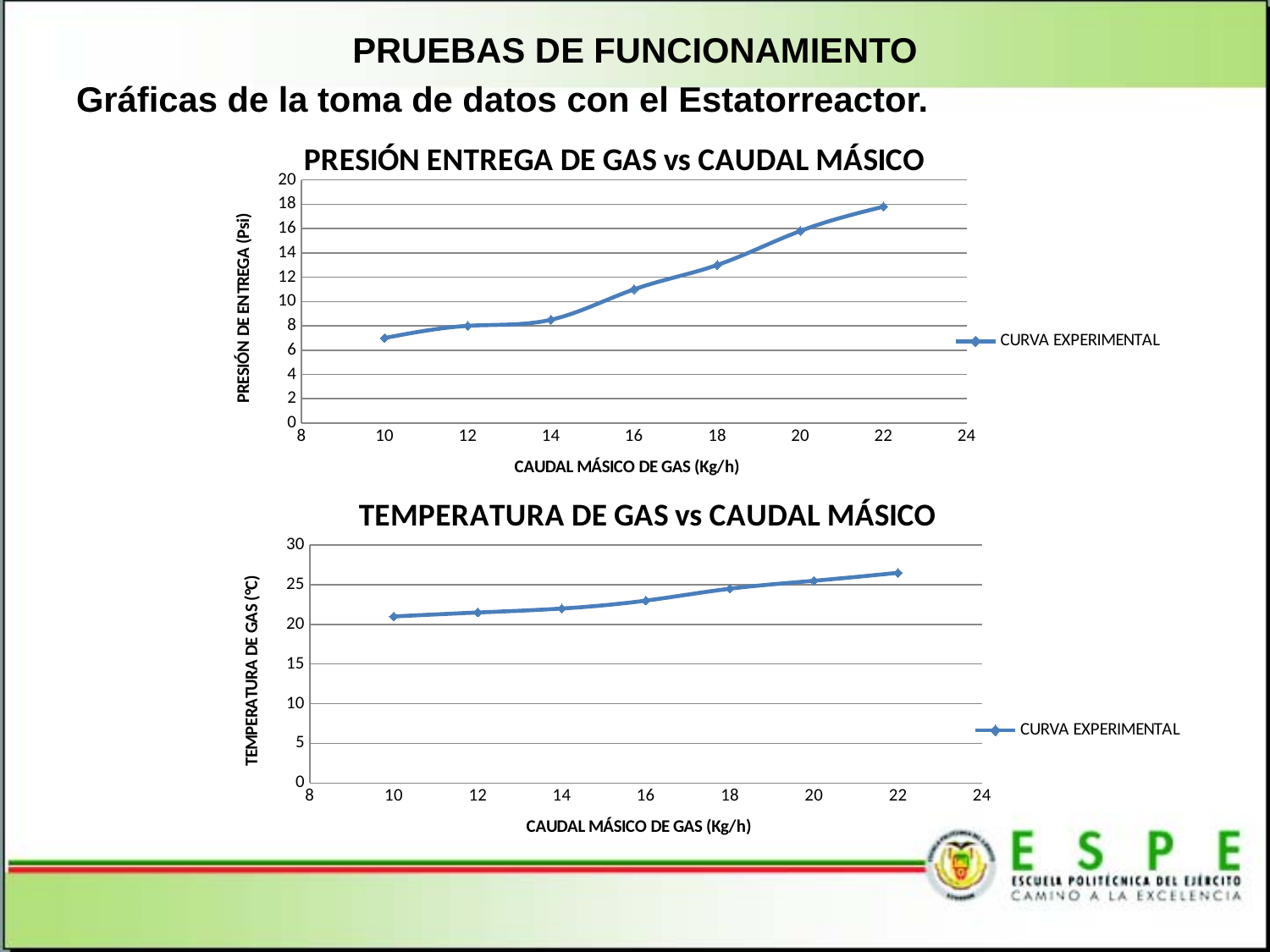
In the 'TEMPERATURA DE GAS vs CAUDAL MÁSICO' chart, at which caudal másico value is the temperature lowest? 10 In the 'TEMPERATURA DE GAS vs CAUDAL MÁSICO' chart, is the value at a caudal másico of 10 greater or less than 20? greater What kind of chart is the 'PRESIÓN ENTREGA DE GAS vs CAUDAL MÁSICO' chart? Line chart In the 'PRESIÓN ENTREGA DE GAS vs CAUDAL MÁSICO' chart, do the values rise or fall as the caudal másico increases? Rise How many series does the legend of the 'PRESIÓN ENTREGA DE GAS vs CAUDAL MÁSICO' chart list? 1 What is the legend entry shown in the 'TEMPERATURA DE GAS vs CAUDAL MÁSICO' chart? CURVA EXPERIMENTAL In the 'TEMPERATURA DE GAS vs CAUDAL MÁSICO' chart, is the value at a caudal másico of 22 greater or less than 25? greater What is the y-axis title of the 'TEMPERATURA DE GAS vs CAUDAL MÁSICO' chart? TEMPERATURA DE GAS (°C) In the 'PRESIÓN ENTREGA DE GAS vs CAUDAL MÁSICO' chart, at which caudal másico value is the pressure highest? 22 In the 'PRESIÓN ENTREGA DE GAS vs CAUDAL MÁSICO' chart, is the value at a caudal másico of 10 greater or less than 8? less In the 'TEMPERATURA DE GAS vs CAUDAL MÁSICO' chart, how many data points are plotted? 7